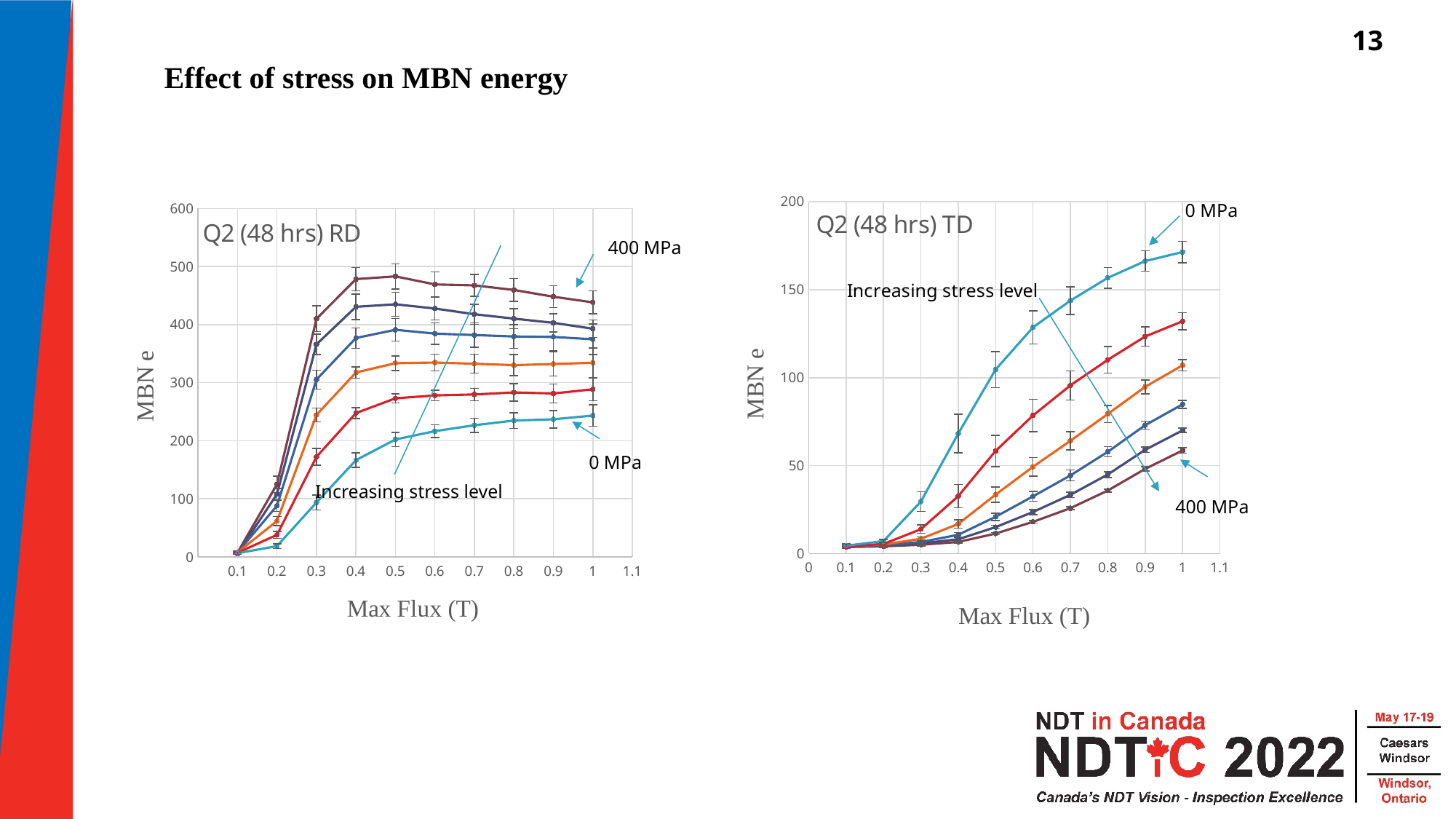
In the left chart "Q2 (48 hrs) RD", is the peak value of the 400 MPa line greater or less than 500? less In the right chart "Q2 (48 hrs) TD", is the value of the 400 MPa line at 1 T greater or less than 100? less What kind of chart is the left chart titled "Q2 (48 hrs) RD"? line chart In the left chart "Q2 (48 hrs) RD", how many lines (stress levels) are plotted? 6 In the right chart "Q2 (48 hrs) TD", how many lines (stress levels) are plotted? 6 In the right chart "Q2 (48 hrs) TD", does the 0 MPa line rise or fall as Max Flux increases from 0.1 T to 1 T? rise In the left chart "Q2 (48 hrs) RD", is the value of the 0 MPa line at 1 T greater or less than 300? less In the left chart "Q2 (48 hrs) RD", which line is higher at 1 T, 0 MPa or 400 MPa? 400 MPa What is the x-axis label of the left chart "Q2 (48 hrs) RD"? Max Flux (T) In the right chart "Q2 (48 hrs) TD", which line is higher at 1 T, 0 MPa or 400 MPa? 0 MPa